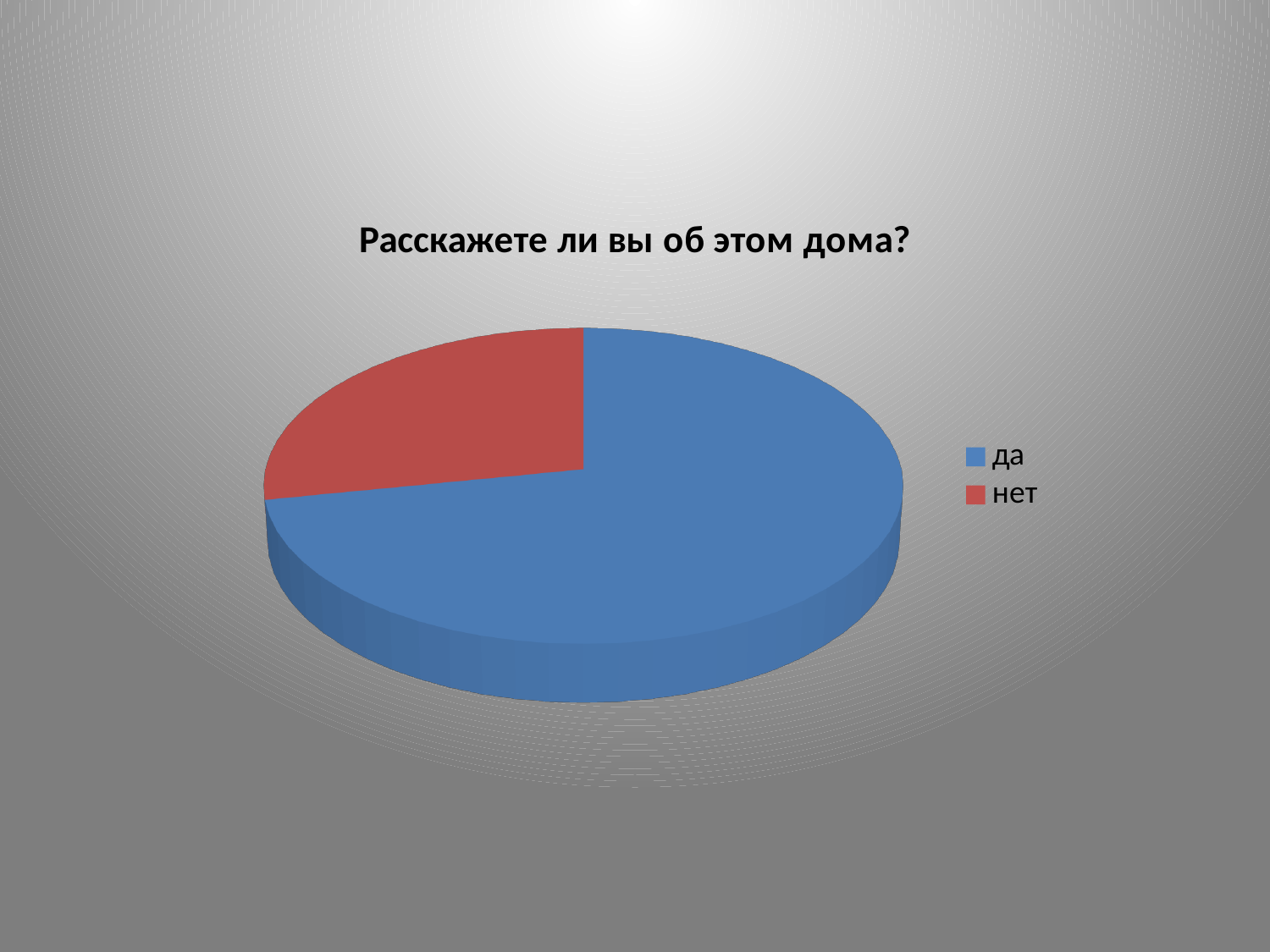
Which slice is larger, да or нет? да How many slices does the pie chart have? 2 What kind of chart is shown on the slide? pie chart How many entries does the legend list? 2 Which category has the smallest slice of the pie? нет Which category has the largest slice of the pie? да What is the title of the chart? Расскажете ли вы об этом дома? What colour is the slice for нет? red